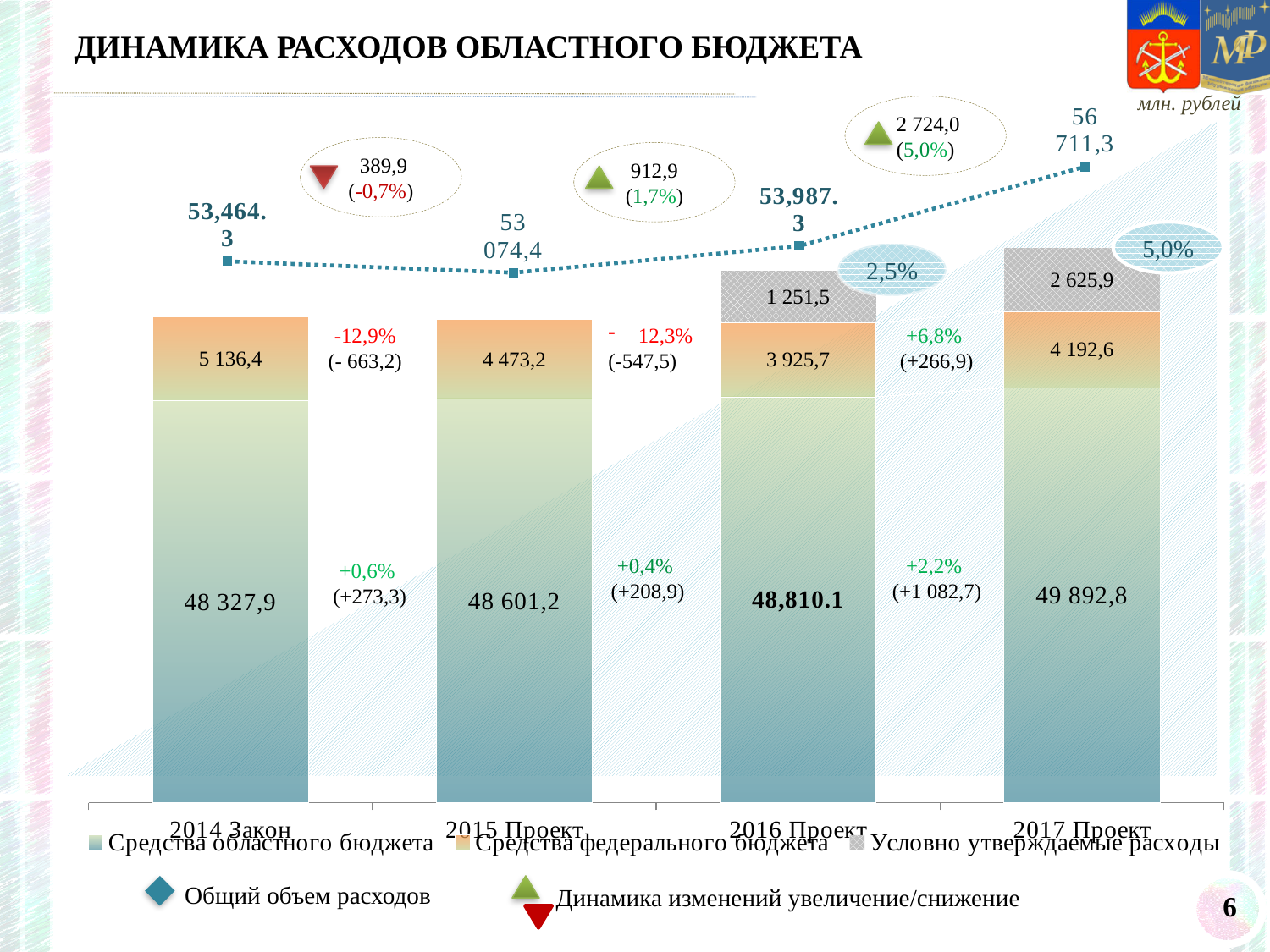
What is the difference between Средства федерального бюджета in 2014 Закон and 2015 Проект? 663,2 What is the value of Средства областного бюджета for 2014 Закон? 48 327,9 How many years (categories) are shown on the x axis? 4 Which year has the highest value for Средства областного бюджета? 2017 Проект What is the value of Общий объем расходов (the line) for 2017 Проект? 56 711,3 Which year has the lowest value for Средства федерального бюджета? 2016 Проект Which is larger: Средства федерального бюджета in 2014 Закон or in 2017 Проект? 2014 Закон What is the value of Средства федерального бюджета for 2015 Проект? 4 473,2 Does the Общий объем расходов line rise or fall from 2015 Проект to 2017 Проект? Rise What is the value of Условно утверждаемые расходы for 2017 Проект? 2 625,9 What is the title of the chart? ДИНАМИКА РАСХОДОВ ОБЛАСТНОГО БЮДЖЕТА What kind of chart is shown on the slide? Stacked bar chart with a line